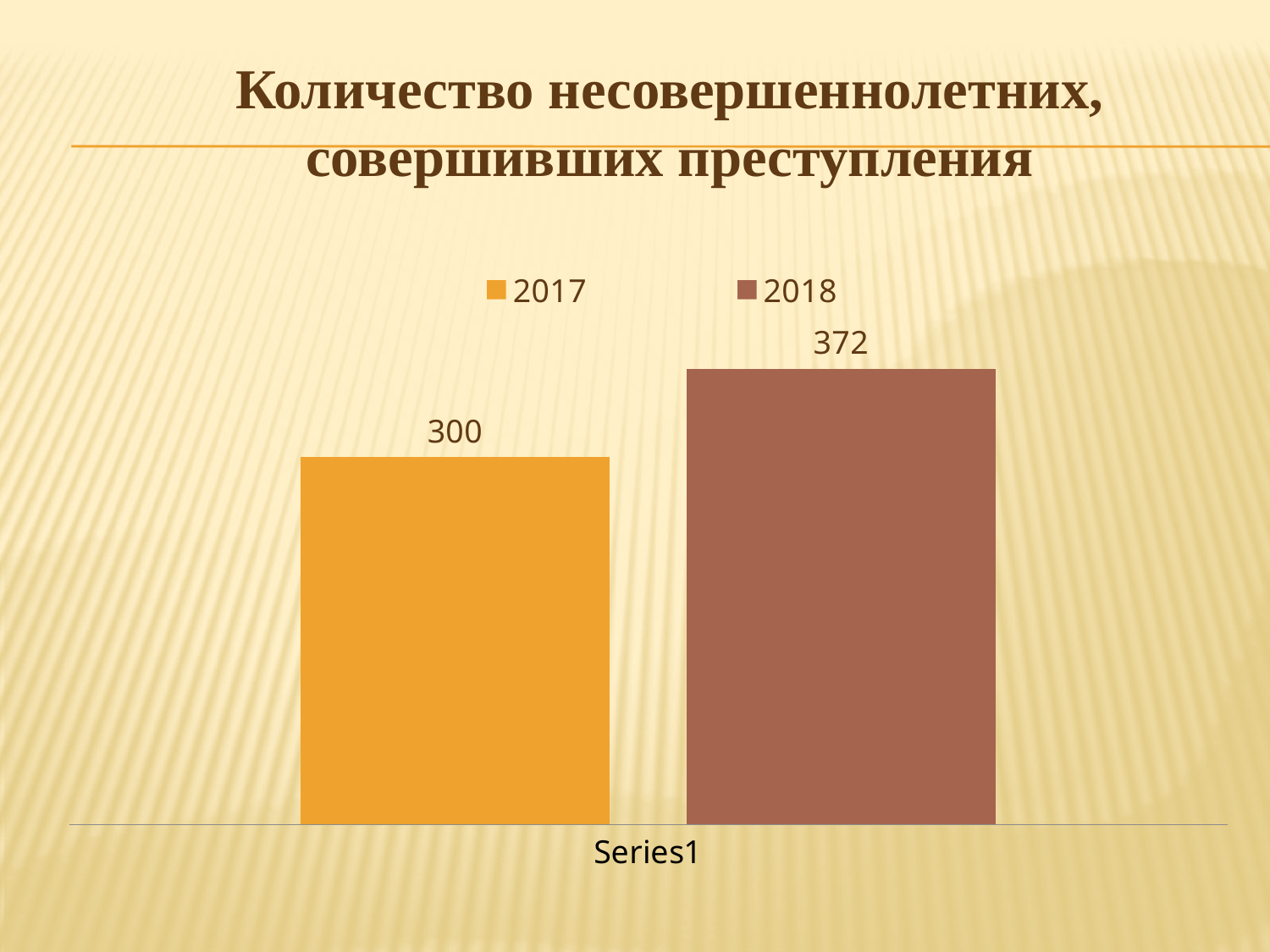
What is the value for 2017? 300 What is the difference between the values for 2018 and 2017? 72 What is the category label shown on the x axis? Series1 Is the value for 2018 larger than the value for 2017? Yes What colour is the bar for 2017? Orange Which year has the higher value? 2018 How many series does the legend list? 2 What is the total of the two bars? 672 What is the value for 2018? 372 Which year has the lower value? 2017 What kind of chart is shown on the slide? Bar chart How many bars are plotted in the chart? 2